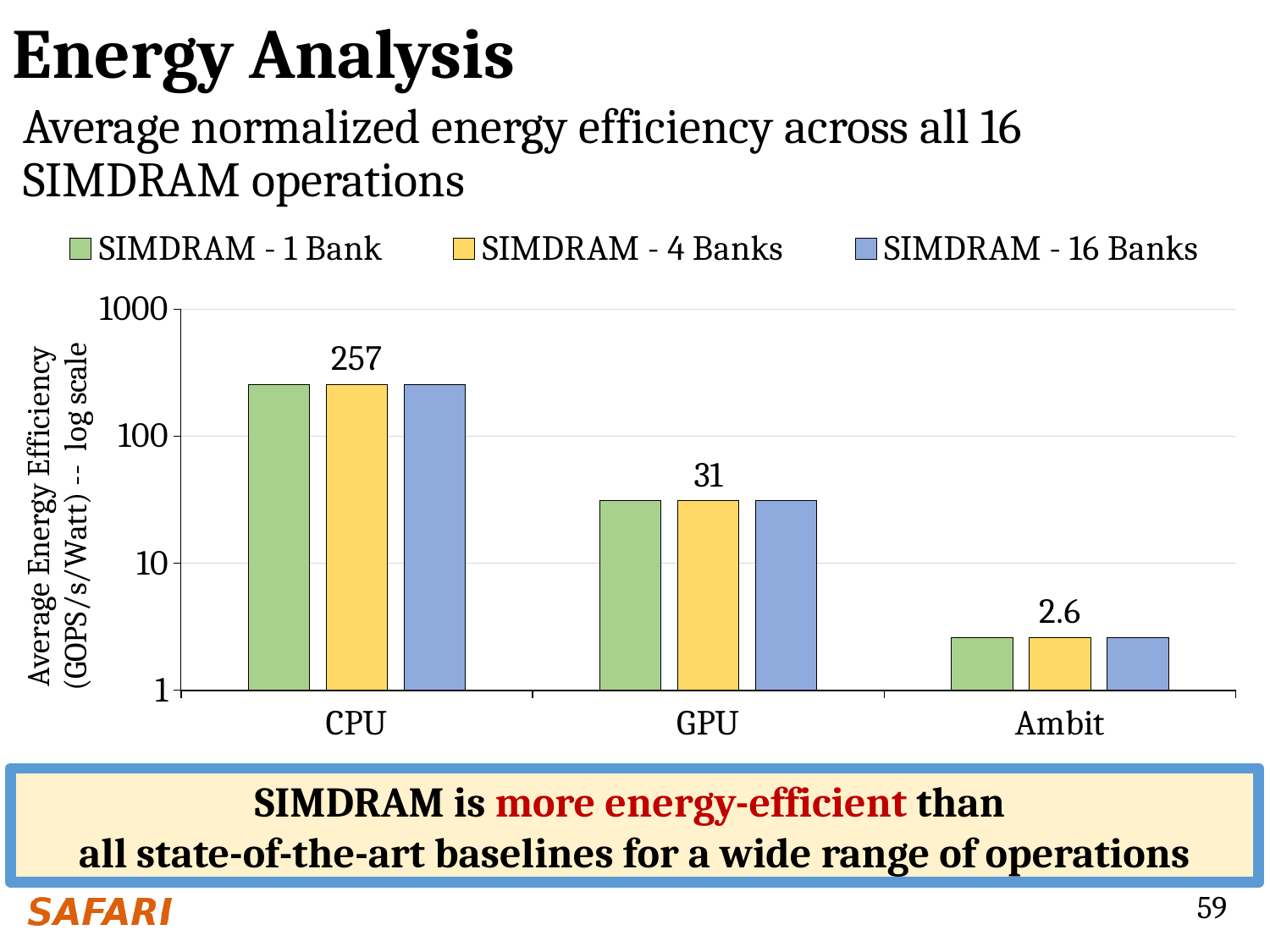
What is the average energy efficiency value labeled for the Ambit group? 2.6 Which baseline category has the lowest average energy efficiency? Ambit Which baseline category has the highest average energy efficiency? CPU What kind of chart is shown on the slide? bar chart What is the difference between the labeled values for CPU and GPU? 226 How many baseline categories are shown on the x axis? 3 What is the average energy efficiency value labeled for the CPU group? 257 Do the values rise or fall moving from CPU to Ambit along the x axis? fall What is the average energy efficiency value labeled for the GPU group? 31 How many series does the legend list? 3 Is the value for the Ambit bars greater or less than 10? less Which has a larger labeled value, GPU or Ambit? GPU